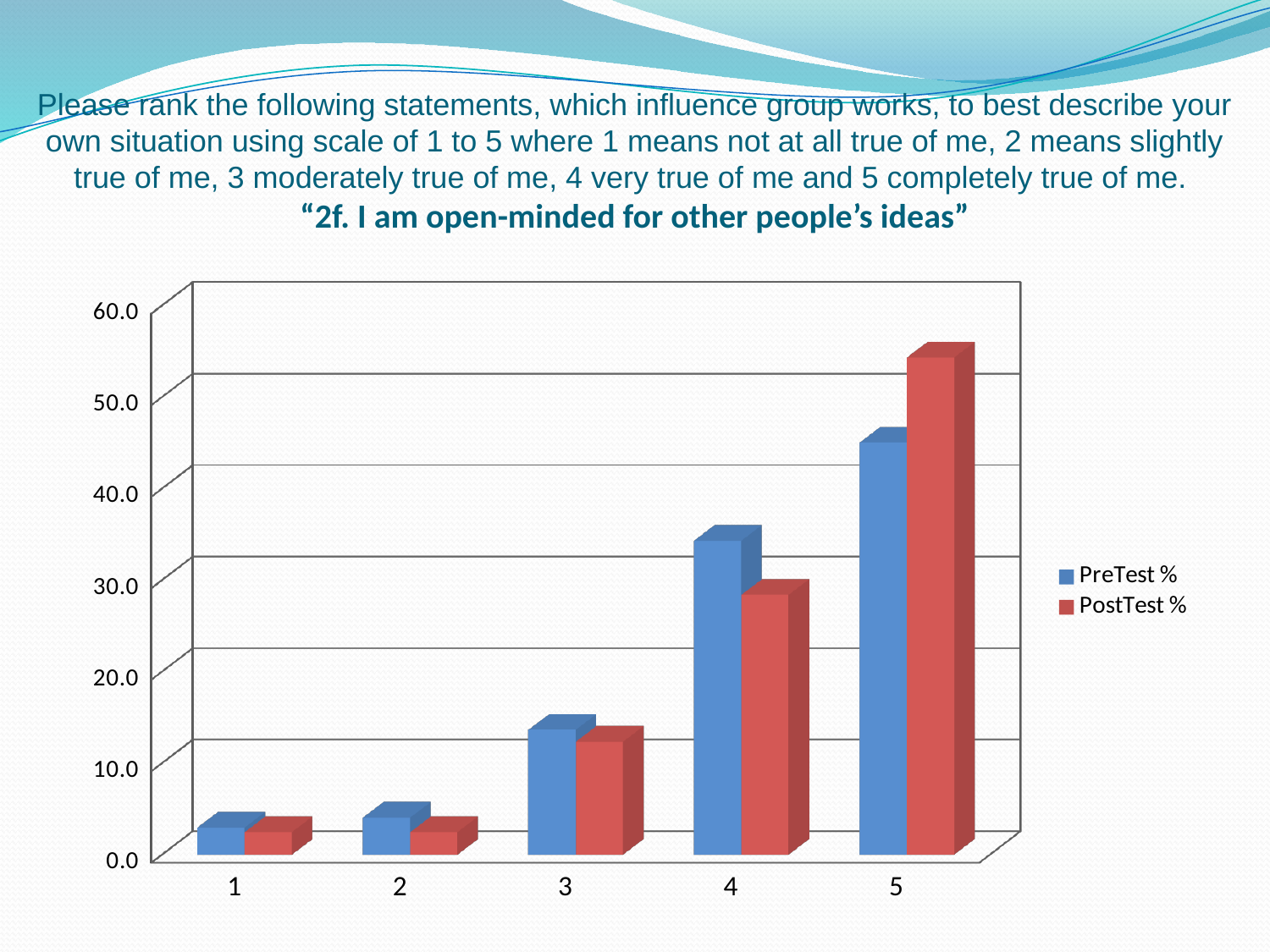
Is the PreTest % value for category 5 greater or less than 50? less Is the PostTest % value for category 5 greater or less than 50? greater What kind of chart is shown on the slide? bar chart How many categories are shown on the x axis? 5 For category 4, which is larger, PreTest % or PostTest %? PreTest % Which category has the highest PreTest % value? 5 How many series does the legend list? 2 Do the PostTest % values rise or fall from category 1 to category 5? rise Which category has the highest PostTest % value? 5 Is the PreTest % value for category 4 greater or less than 30? greater For category 5, which is larger, PreTest % or PostTest %? PostTest %